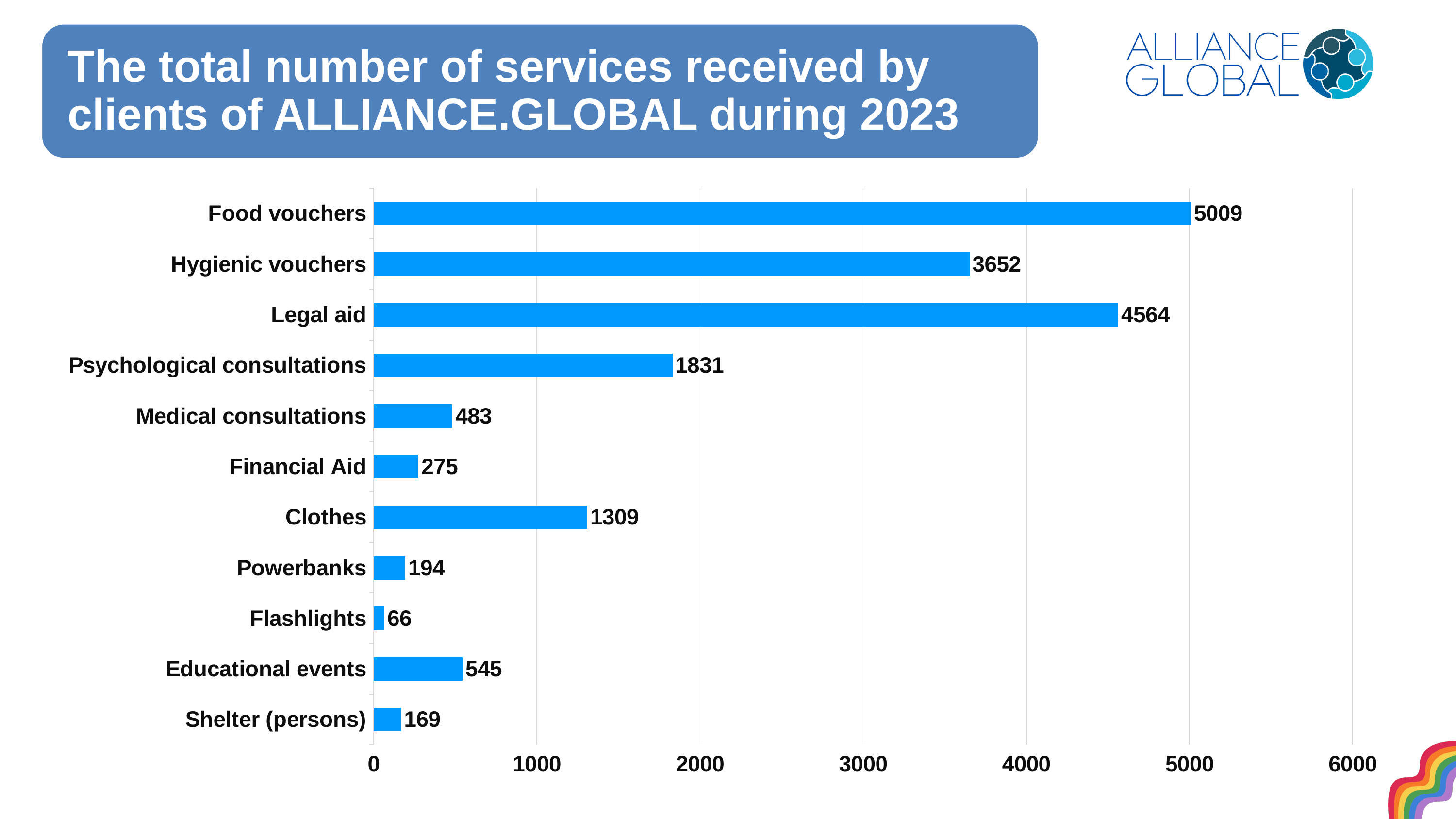
What is the title of the chart on the slide? The total number of services received by clients of ALLIANCE.GLOBAL during 2023 What is the value for Shelter (persons)? 169 Which category has the highest value? Food vouchers What is the difference between Educational events and Medical consultations? 62 What is the value for Food vouchers? 5009 What is the difference between Food vouchers and Hygienic vouchers? 1357 Which category has the lowest value? Flashlights What is the value for Psychological consultations? 1831 Which is larger, Clothes or Psychological consultations? Psychological consultations How many categories are shown in the chart? 11 What kind of chart is shown on the slide? Bar chart What is the value for Legal aid? 4564